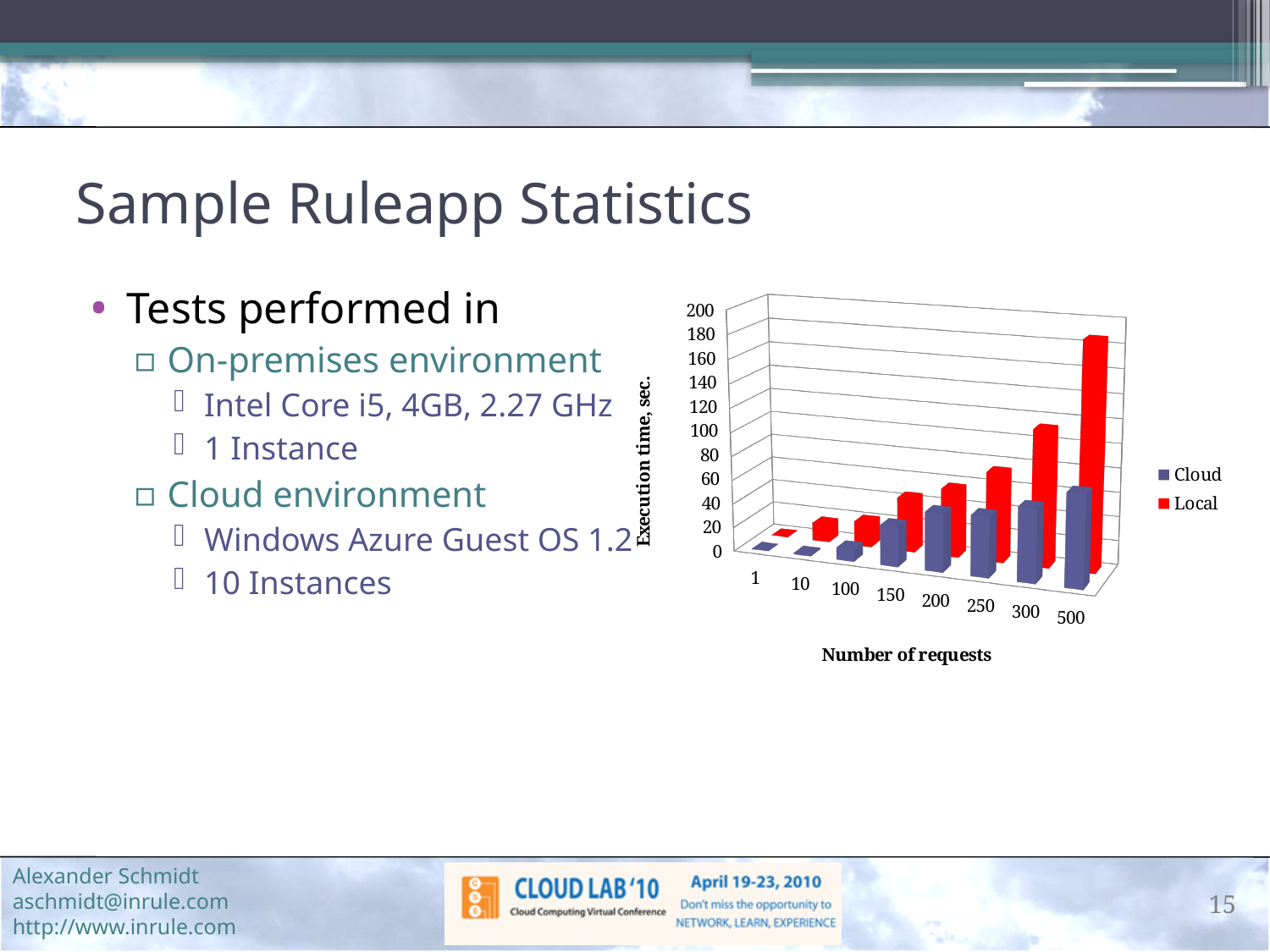
What kind of chart is shown on the slide? bar chart What is the label of the horizontal axis of the chart? Number of requests Which series has the highest bar in the chart, and at which number of requests? Local at 500 Is the Cloud execution time for 500 requests greater or less than 100? less Is the Local execution time for 10 requests greater or less than 100? less For 300 requests, which series has the larger execution time, Cloud or Local? Local What is the label of the vertical axis of the chart? Execution time, sec. Does the Local execution time rise or fall as the number of requests increases along the x axis? rise Is the Local execution time for 500 requests greater or less than 140? greater For 500 requests, which series has the larger execution time, Cloud or Local? Local How many series does the chart's legend list? 2 How many categories (numbers of requests) are shown on the x axis of the chart? 8